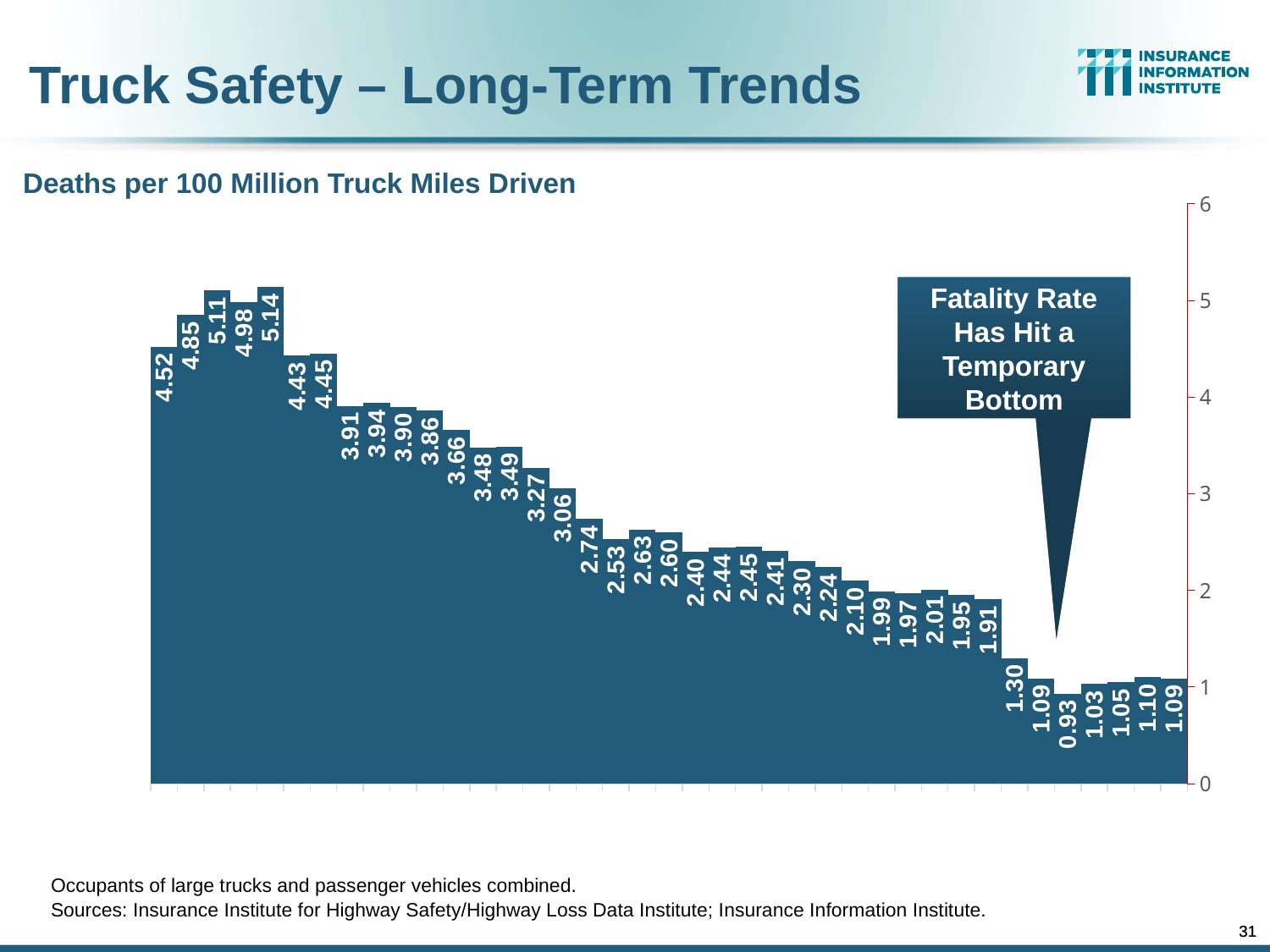
What is the difference between the first bar (4.52) and the last bar (1.09)? 3.43 What does the callout box on the chart say? Fatality Rate Has Hit a Temporary Bottom Which is larger, the value of the first bar or the value of the last bar? The first bar (4.52) What is the title of the chart? Deaths per 100 Million Truck Miles Driven Is the value of the tallest bar greater or less than 5? greater Overall, do the values rise or fall from left to right across the chart? fall What is the difference between the highest value (5.14) and the lowest value (0.93) on the chart? 4.21 What kind of chart is shown on the slide? bar chart What is the lowest value shown on the chart? 0.93 What is the value of the last (rightmost) bar on the chart? 1.09 What is the value of the first (leftmost) bar on the chart? 4.52 What is the highest value shown on the chart? 5.14